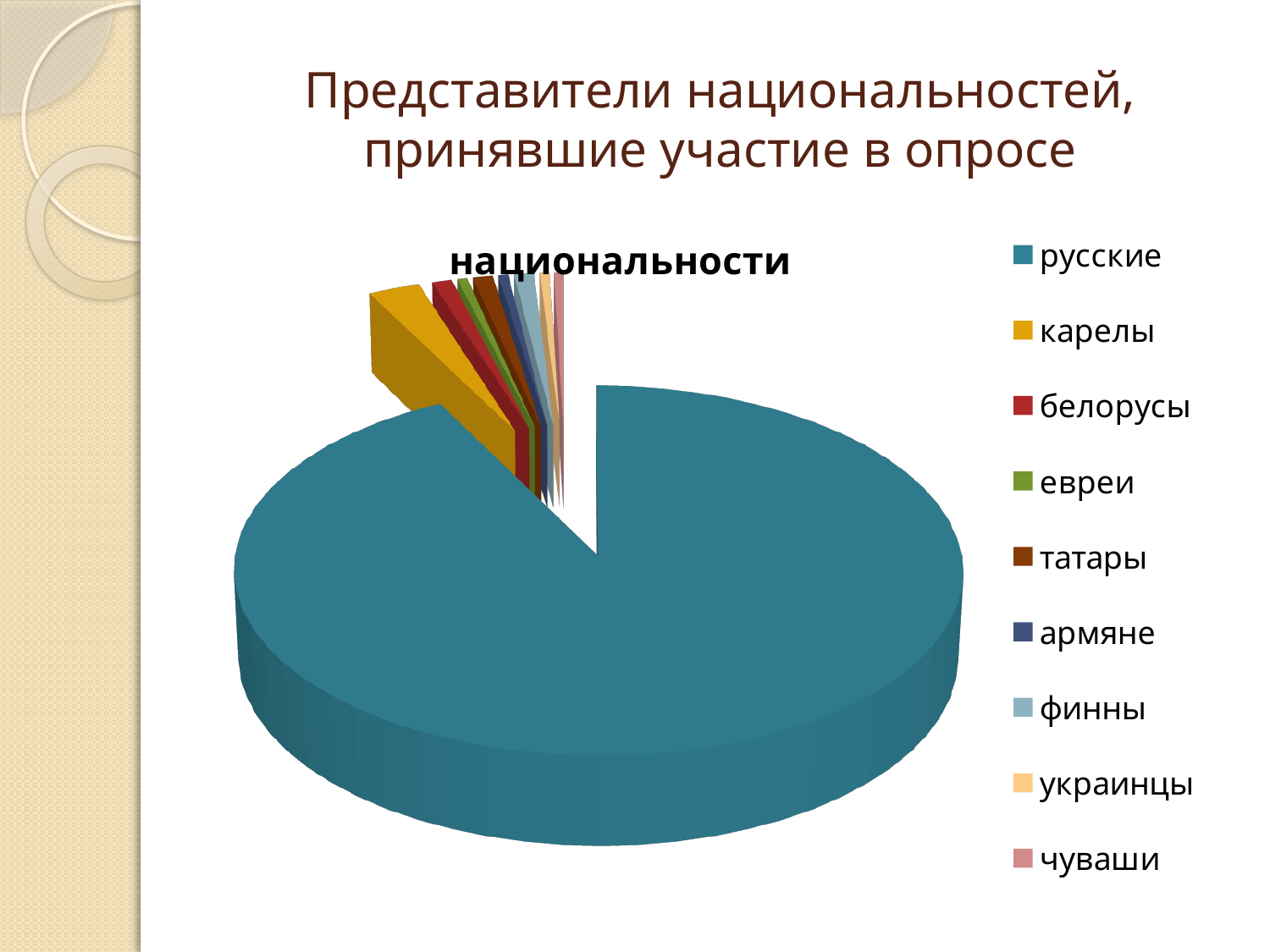
Which nationality has the second-largest slice of the pie chart? карелы Which slice is larger, русские or финны? русские Which slice is larger, карелы or белорусы? карелы How many nationalities (categories) does the pie chart show? 9 Which slice is larger, карелы or евреи? карелы What kind of chart is shown on the slide? pie chart Which nationality has the largest slice of the pie chart? русские Which nationality is listed last in the legend? чуваши What is the title of the pie chart? национальности